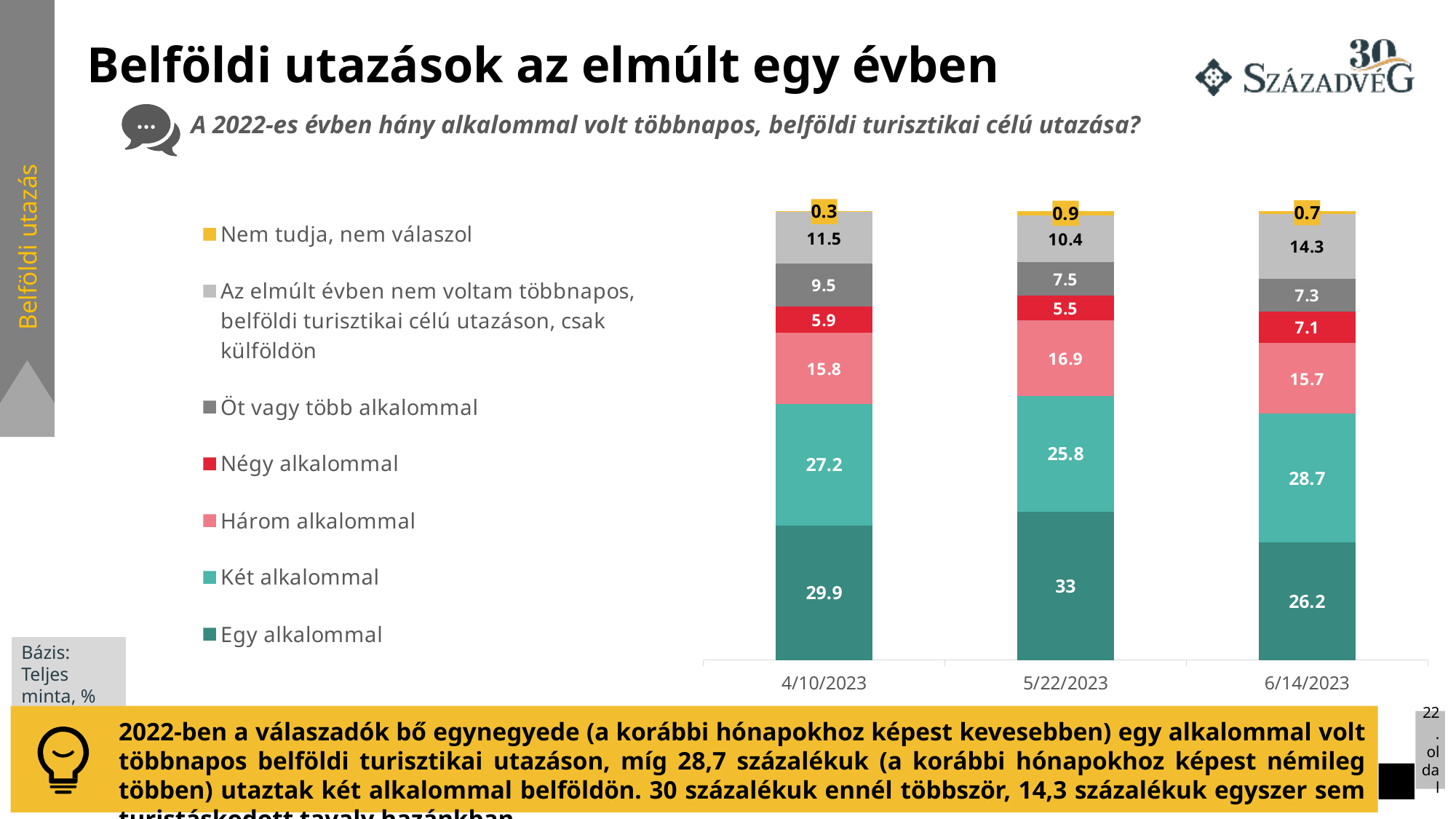
What is the value for "Egy alkalommal" on 5/22/2023? 33 What is the total of the stacked bar for 5/22/2023? 100 Does the value for "Öt vagy több alkalommal" rise or fall across the three dates? Fall What is the value for "Két alkalommal" on 6/14/2023? 28.7 How many dates are shown on the x axis? 3 How many series does the legend list? 7 What is the value for "Nem tudja, nem válaszol" on 4/10/2023? 0.3 What kind of chart is shown on the slide? Stacked bar chart What is the difference between the "Egy alkalommal" values on 5/22/2023 and 6/14/2023? 6.8 On which date is the value for "Az elmúlt évben nem voltam többnapos, belföldi turisztikai célú utazáson, csak külföldön" the lowest? 5/22/2023 On which date is the value for "Egy alkalommal" the highest? 5/22/2023 On 6/14/2023, which is larger: "Egy alkalommal" or "Két alkalommal"? Két alkalommal